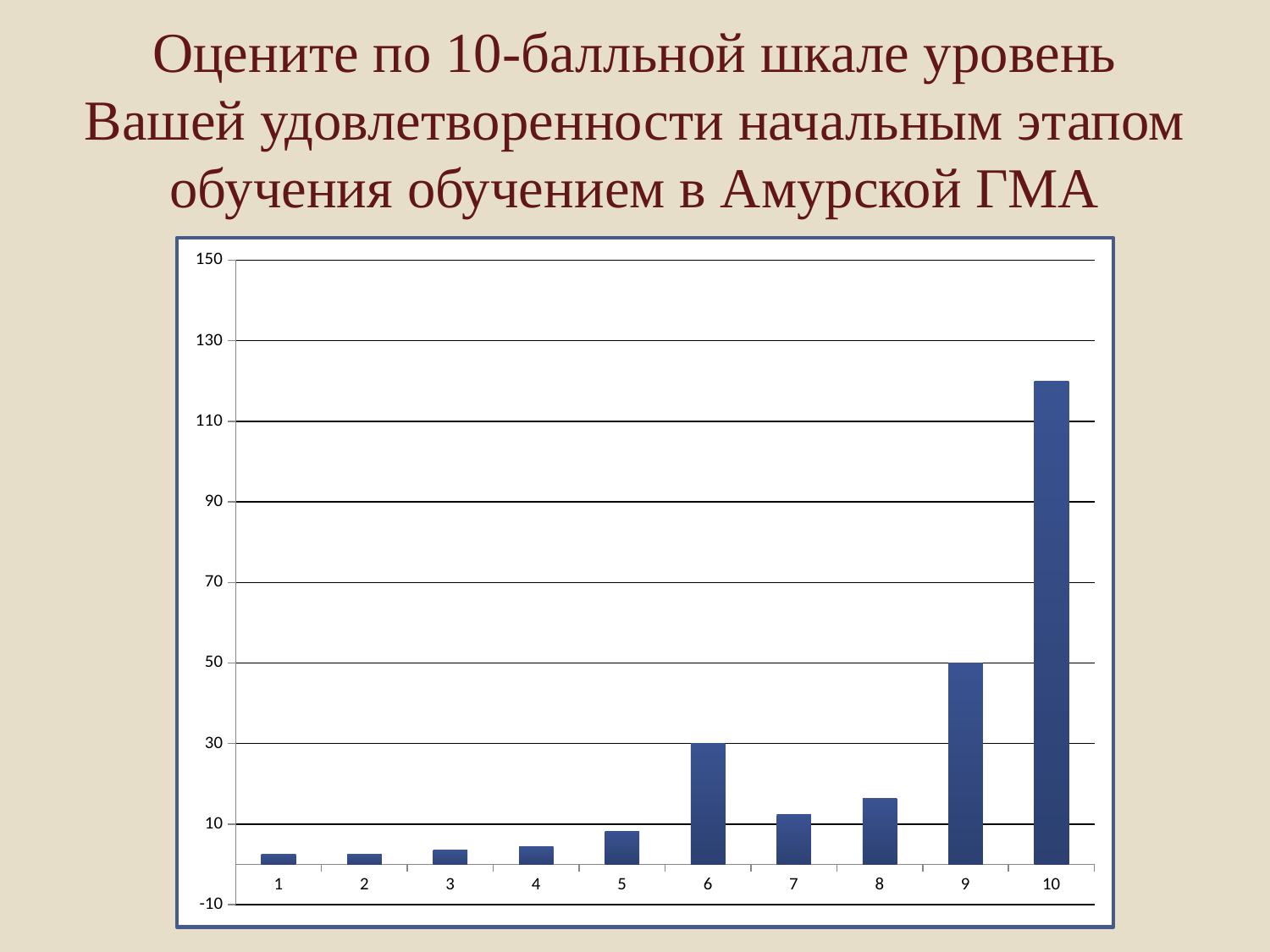
What is the value for category 9? 50 Is the value for category 10 greater or less than 110? greater Which category has the highest bar in the chart? 10 What kind of chart is shown on the slide? bar chart Is the value for category 8 greater or less than 10? greater How many categories are shown on the x axis of the chart? 10 Which is larger, the value for category 9 or the value for category 7? 9 Do the values generally rise or fall as the categories go from 1 to 10? rise What is the difference between the values for category 9 and category 6? 20 What is the value for category 6? 30 What is the highest value shown on the y axis of the chart? 150 Is the value for category 5 greater or less than 10? less